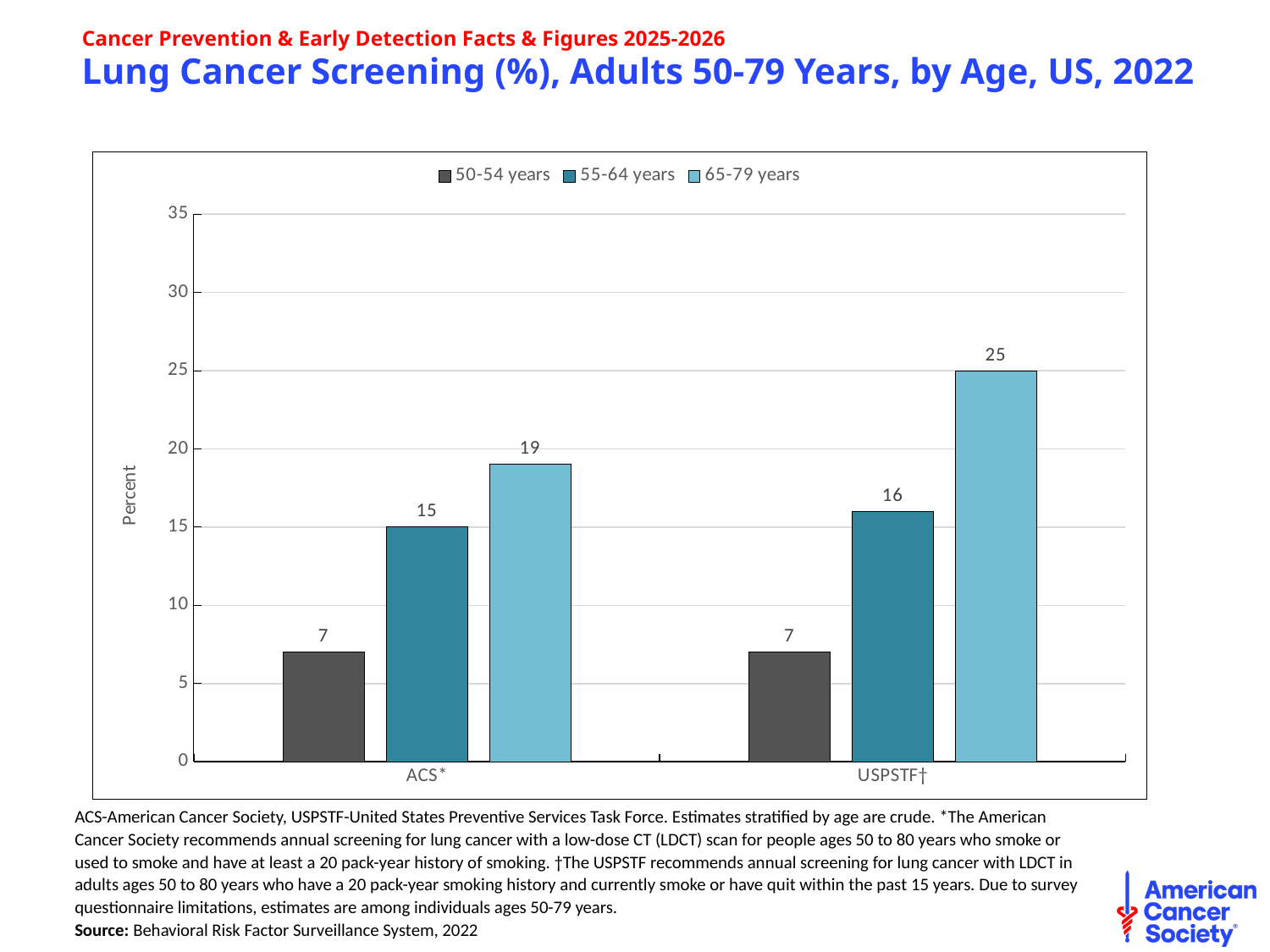
What is the difference between the 65-79 years and 50-54 years values under the ACS* criteria? 12 Which is larger: the 55-64 years value for ACS* or for USPSTF†? USPSTF† What is the lung cancer screening percentage for adults 65-79 years under the ACS* criteria? 19 Which age group has the highest screening percentage under the USPSTF† criteria? 65-79 years Which age group has the lowest screening percentage under the ACS* criteria? 50-54 years What is the difference between the 65-79 years values for USPSTF† and ACS*? 6 How many series does the legend list? 3 Is the value for 65-79 years under USPSTF† greater or less than 20? greater What is the lung cancer screening percentage for adults 55-64 years under the USPSTF† criteria? 16 What kind of chart is shown on the slide? Bar chart What is the label of the y-axis? Percent What is the value for 50-54 years under the ACS* criteria? 7